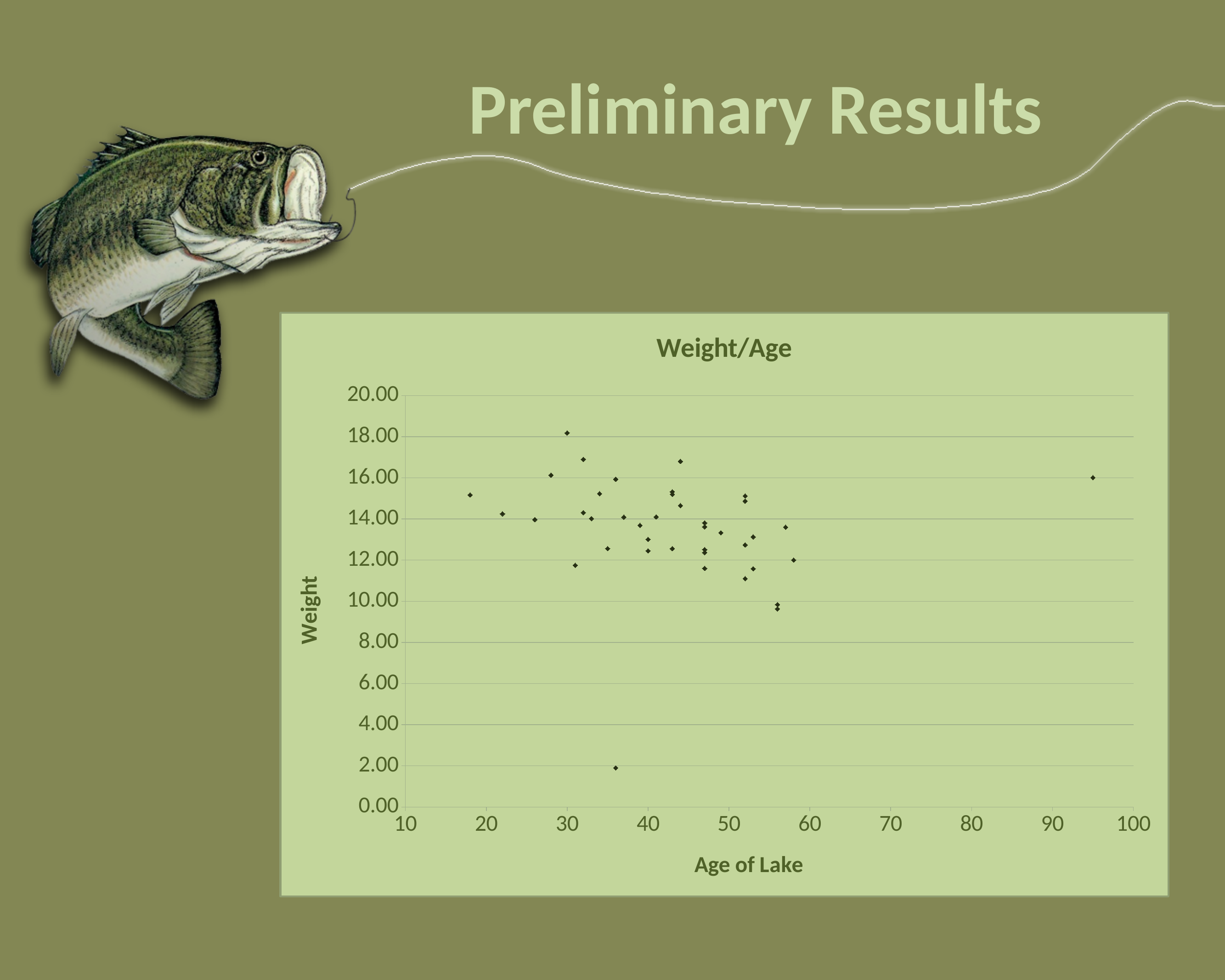
What kind of chart is shown on the slide? scatter plot Is the weight of the point plotted at an age of about 95 greater or less than 14.00? greater What is the label of the x axis of the chart? Age of Lake Are the two points plotted near age 56 greater or less than 12.00 in weight? less Is the weight of the highest point on the chart (near age 30) greater or less than 16.00? greater What is the title of the chart? Weight/Age